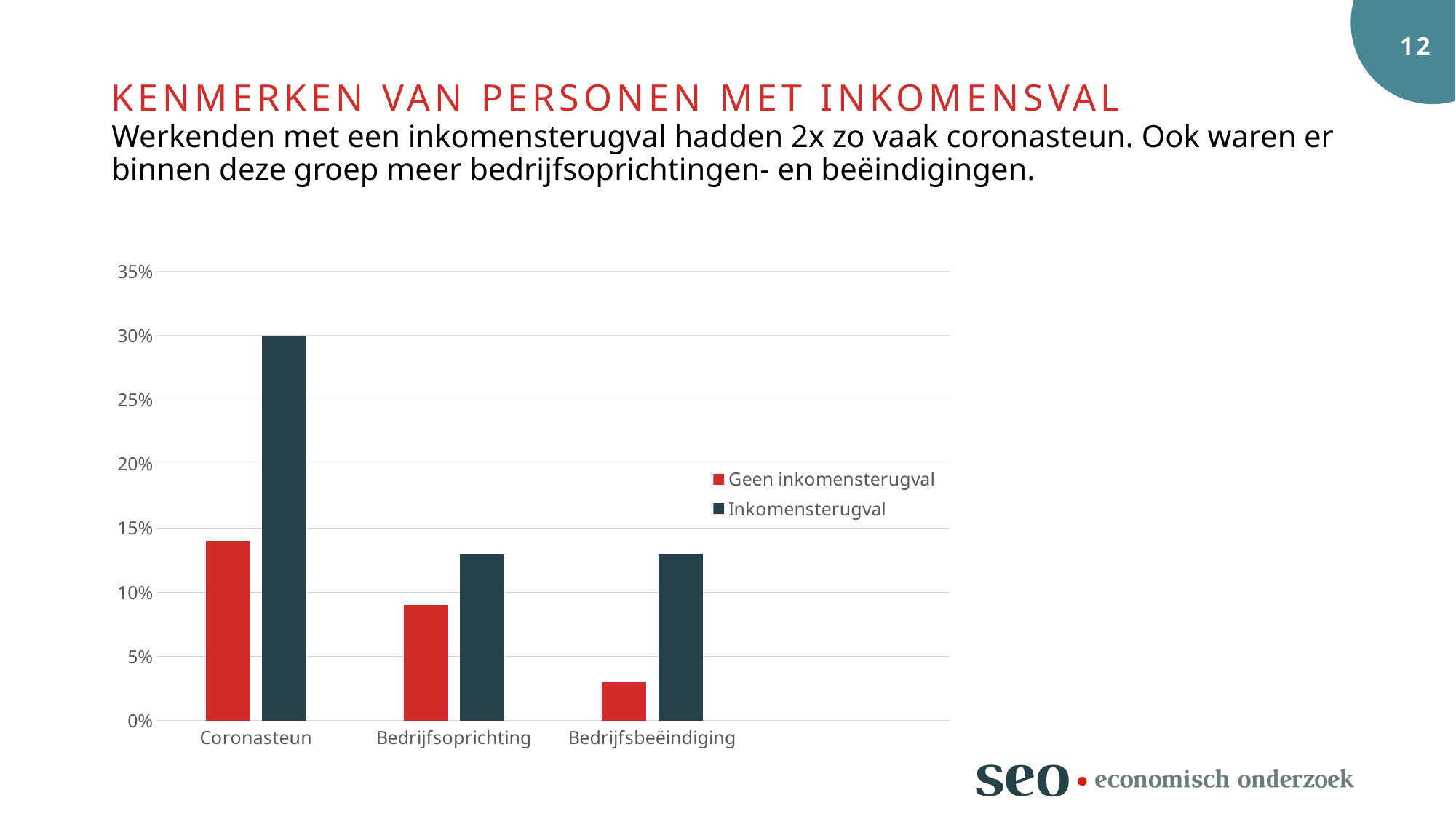
What kind of chart is shown on the slide? bar chart What is the value for Inkomensterugval in the Coronasteun category? 30% Is the value for Geen inkomensterugval in the Bedrijfsoprichting category greater or less than 10%? less Is the value for Geen inkomensterugval in the Bedrijfsbeëindiging category greater or less than 5%? less Is the value for Geen inkomensterugval in the Coronasteun category greater or less than 15%? less Which category has the lowest value for the Geen inkomensterugval series? Bedrijfsbeëindiging Which category has the highest value for the Inkomensterugval series? Coronasteun In the Coronasteun category, which series has the larger value: Geen inkomensterugval or Inkomensterugval? Inkomensterugval How many categories are shown on the x axis? 3 Which series is shown in red in the legend? Geen inkomensterugval How many series does the legend list? 2